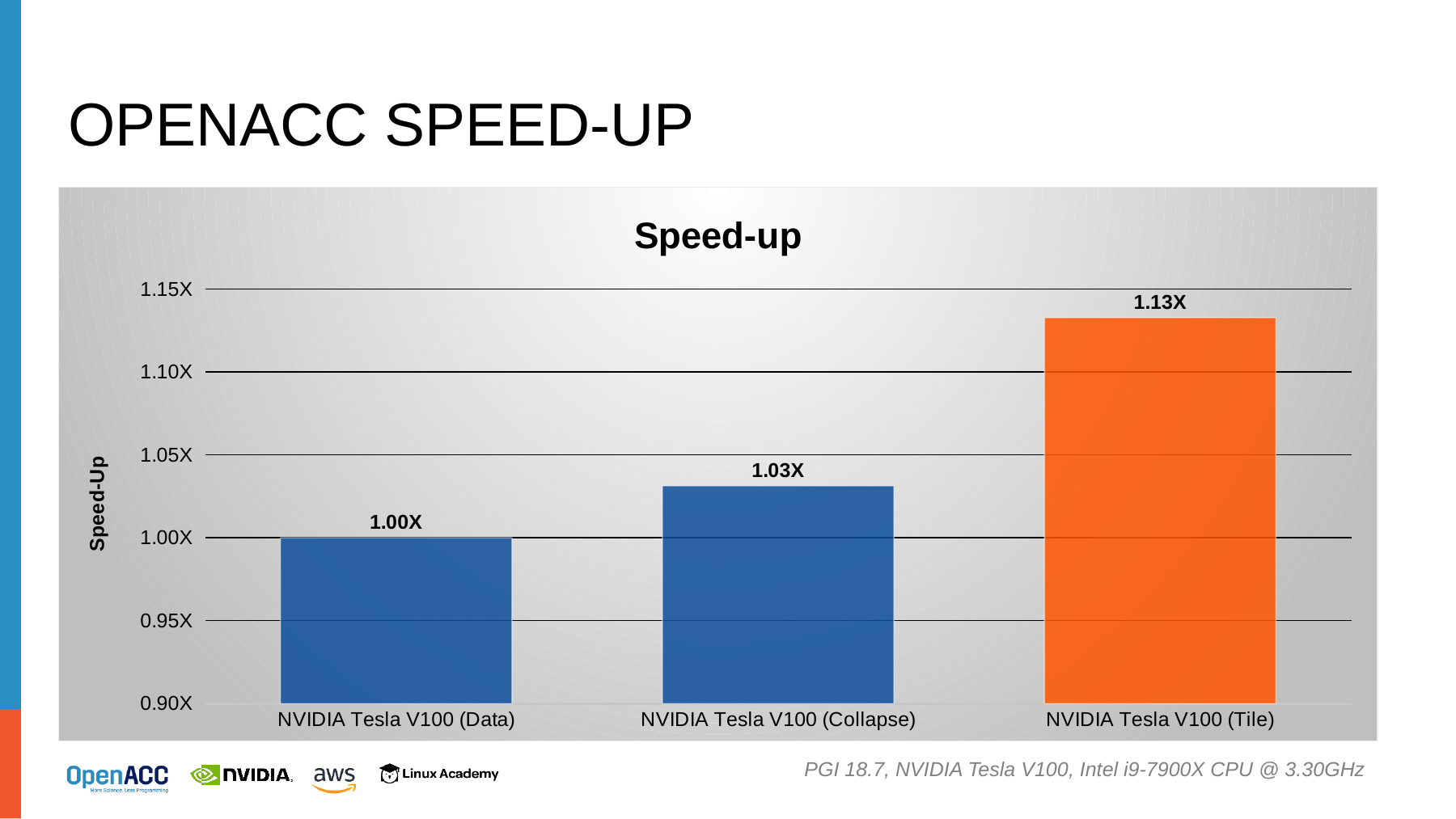
Which has a larger speed-up, NVIDIA Tesla V100 (Collapse) or NVIDIA Tesla V100 (Data)? NVIDIA Tesla V100 (Collapse) Is the speed-up for NVIDIA Tesla V100 (Tile) greater or less than 1.10X? greater Which category has the lowest speed-up? NVIDIA Tesla V100 (Data) What is the title of the chart? Speed-up What is the difference in speed-up between NVIDIA Tesla V100 (Tile) and NVIDIA Tesla V100 (Collapse)? 0.10X What is the speed-up value for NVIDIA Tesla V100 (Tile)? 1.13X How many categories are shown in the chart? 3 Do the speed-up values rise or fall from left to right across the categories? rise Which category has the highest speed-up? NVIDIA Tesla V100 (Tile) What is the speed-up value for NVIDIA Tesla V100 (Data)? 1.00X What kind of chart is shown on the slide? bar chart What is the speed-up value for NVIDIA Tesla V100 (Collapse)? 1.03X